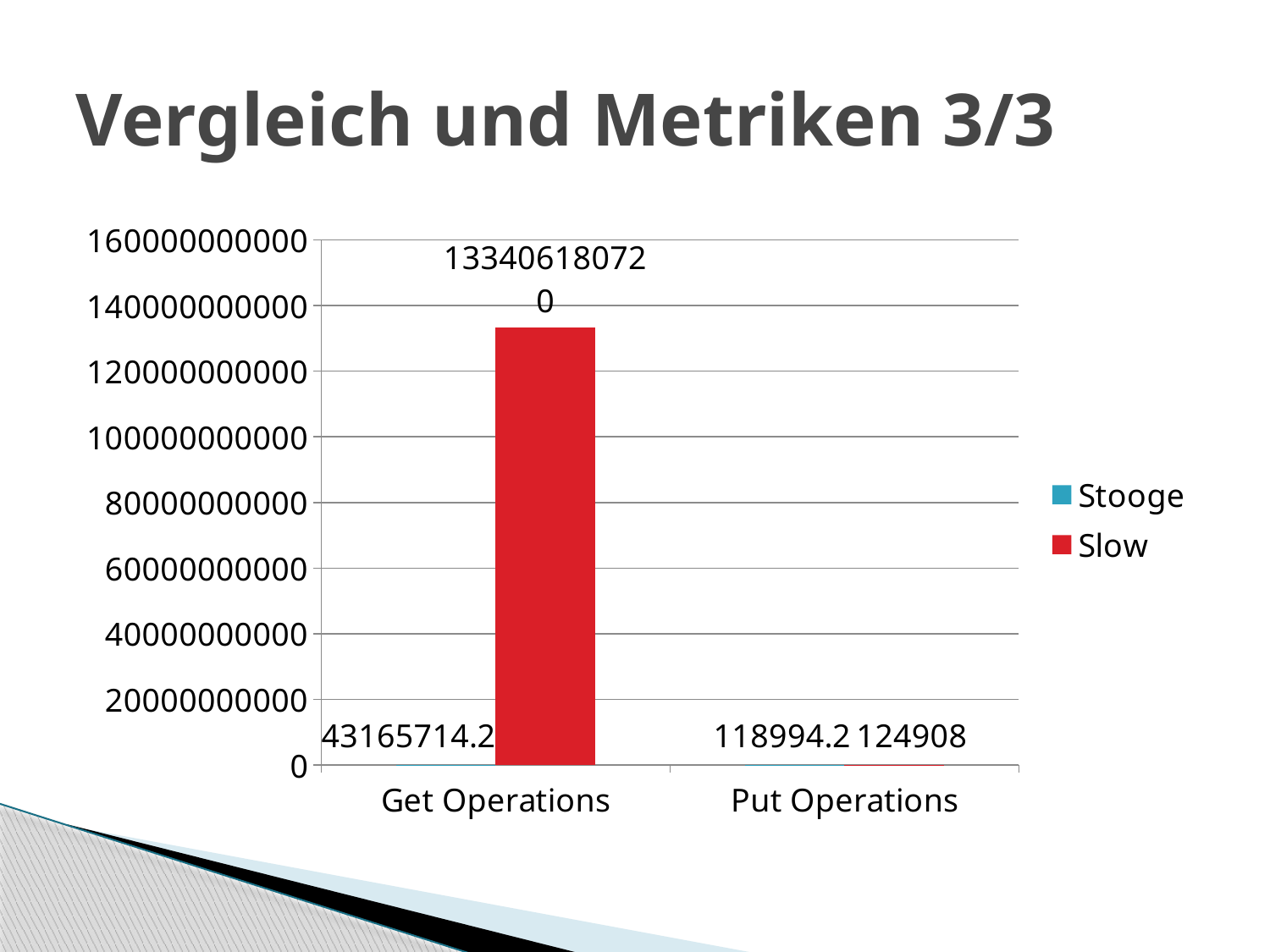
What is the value for Stooge in Put Operations? 118994.2 What type of chart is shown on the slide? bar chart Which bar is the highest in the chart? Slow, Get Operations What is the difference between Slow and Stooge for Put Operations? 5913.8 What is the value for Slow in Put Operations? 124908 How many categories are shown on the x axis? 2 Which is larger for Get Operations, Stooge or Slow? Slow Is the value for Slow in Get Operations greater or less than 120000000000? greater What is the value for Slow in Get Operations? 133406180720 What is the value for Stooge in Get Operations? 43165714.2 Which series are listed in the legend? Stooge and Slow How many series does the legend list? 2